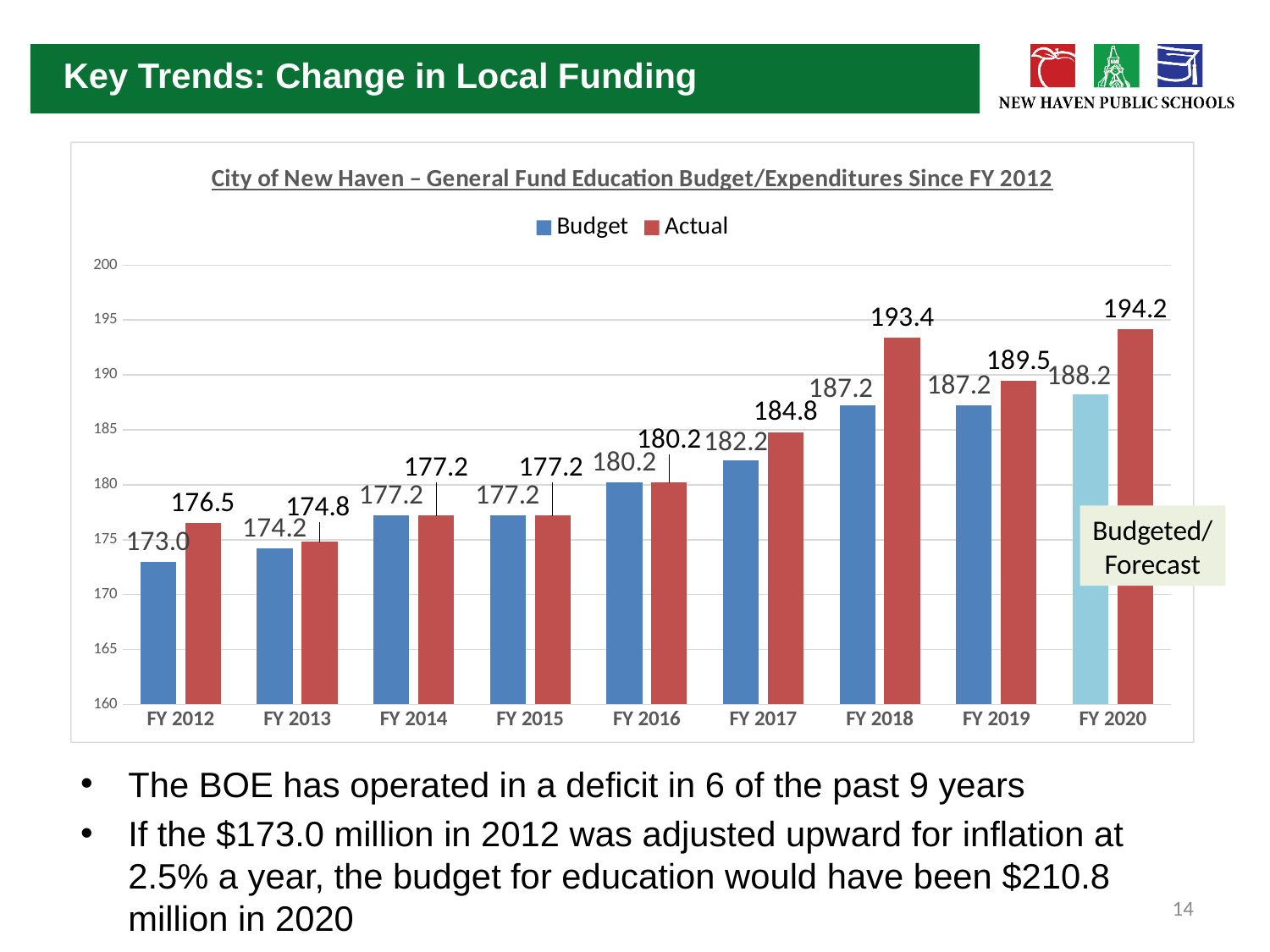
What is the Budget value for FY 2012? 173.0 What is the Actual value for FY 2017? 184.8 Which fiscal year has the highest Actual value? FY 2020 How many fiscal years are shown on the x axis? 9 How many series does the legend list? 2 Which is larger for FY 2019, the Budget value or the Actual value? Actual What is the Budget value for FY 2020? 188.2 What is the Actual value for FY 2018? 193.4 Which fiscal year has the lowest Budget value? FY 2012 What is the difference between the Actual and Budget values for FY 2018? 6.2 What kind of chart is shown on the slide? bar chart Is the Actual value for FY 2016 greater or less than 185? less